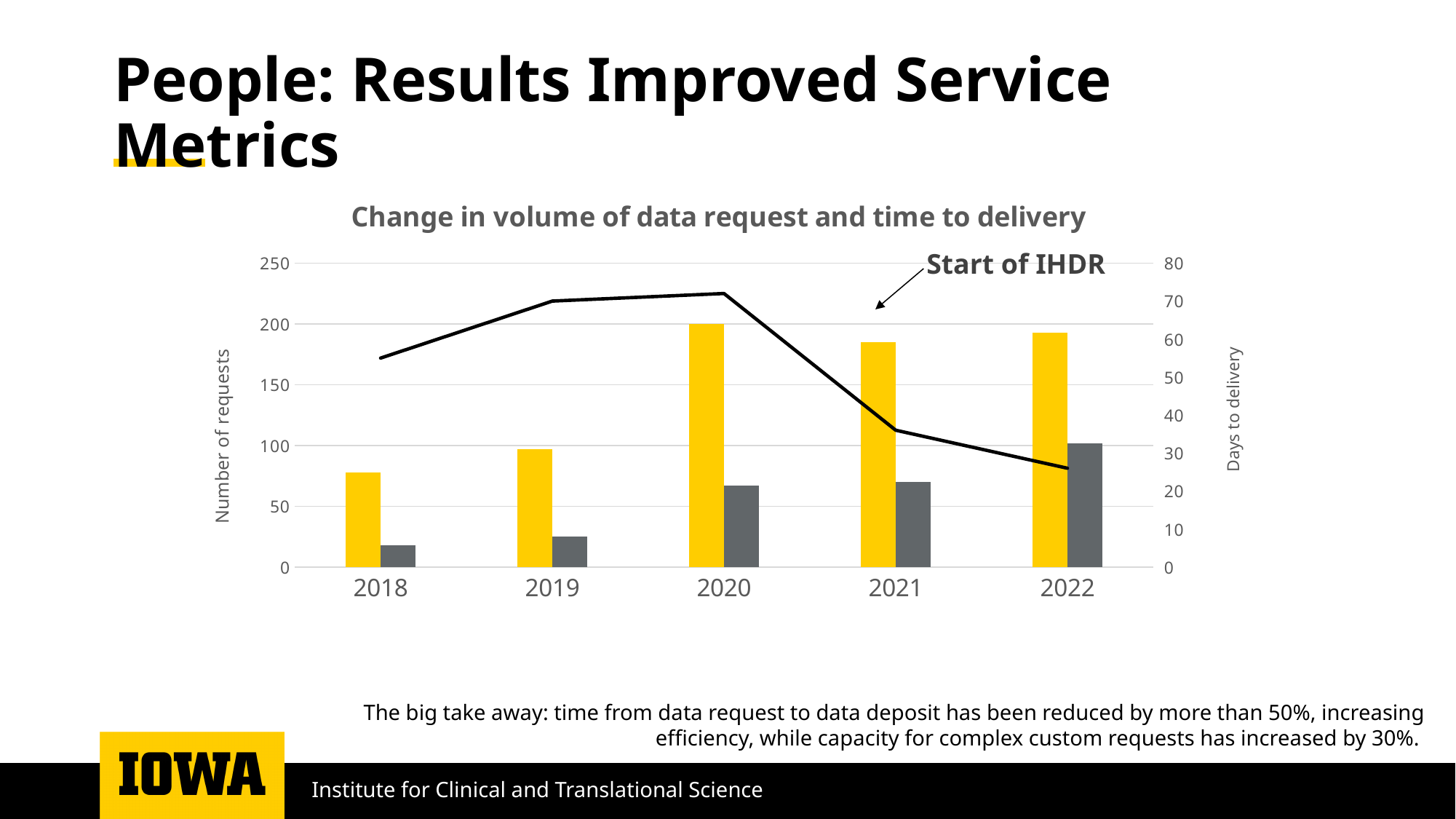
Which is larger, the yellow bar for 2019 or the yellow bar for 2021? 2021 What is the title of the chart? Change in volume of data request and time to delivery How many years are shown on the x axis of the chart? 5 Is the black line value for 2022 greater or less than 30 on the right axis? less What is the label of the right-hand vertical axis? Days to delivery Does the black line rise or fall from 2020 to 2022? Fall In which year is the black line at its lowest point? 2022 What kind of chart is shown on the slide? Combined bar and line chart Is the yellow bar for 2018 greater or less than 100 on the left axis? less In which year is the yellow bar the lowest? 2018 In which year is the gray bar the highest? 2022 Is the yellow bar for 2020 greater or less than 150 on the left axis? greater